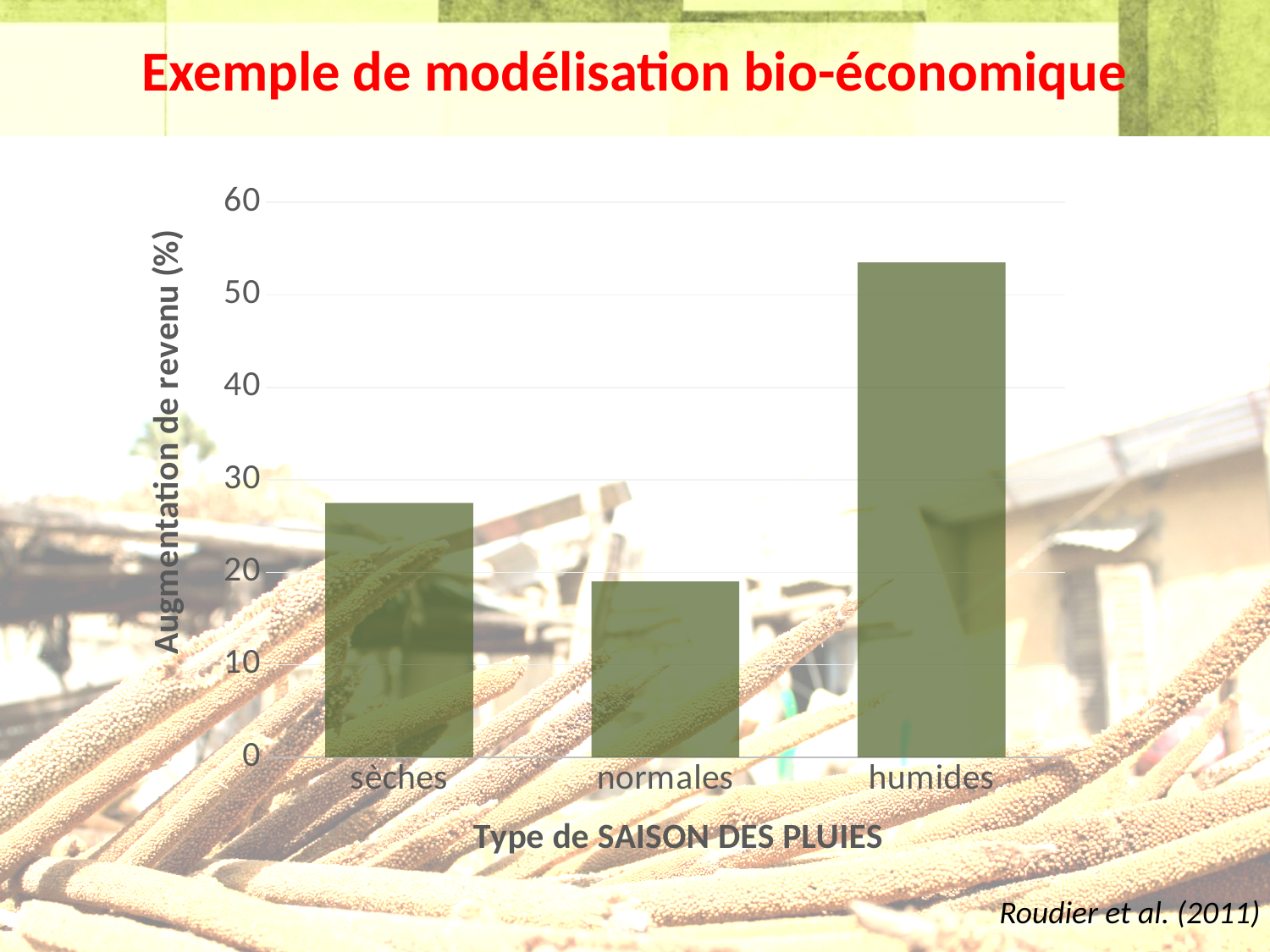
Is the value for normales greater or less than 10? greater How many categories (types of rainy season) are plotted on the x axis? 3 Which type of rainy season has the lowest income increase? normales Is the value for sèches greater or less than 30? less Is the value for sèches greater or less than 20? greater Which type of rainy season has the highest income increase? humides Which has a larger income increase, sèches or normales? sèches What is the label of the vertical axis? Augmentation de revenu (%) What is the label of the horizontal axis? Type de SAISON DES PLUIES Which has a larger income increase, humides or sèches? humides What kind of chart is shown on the slide? bar chart